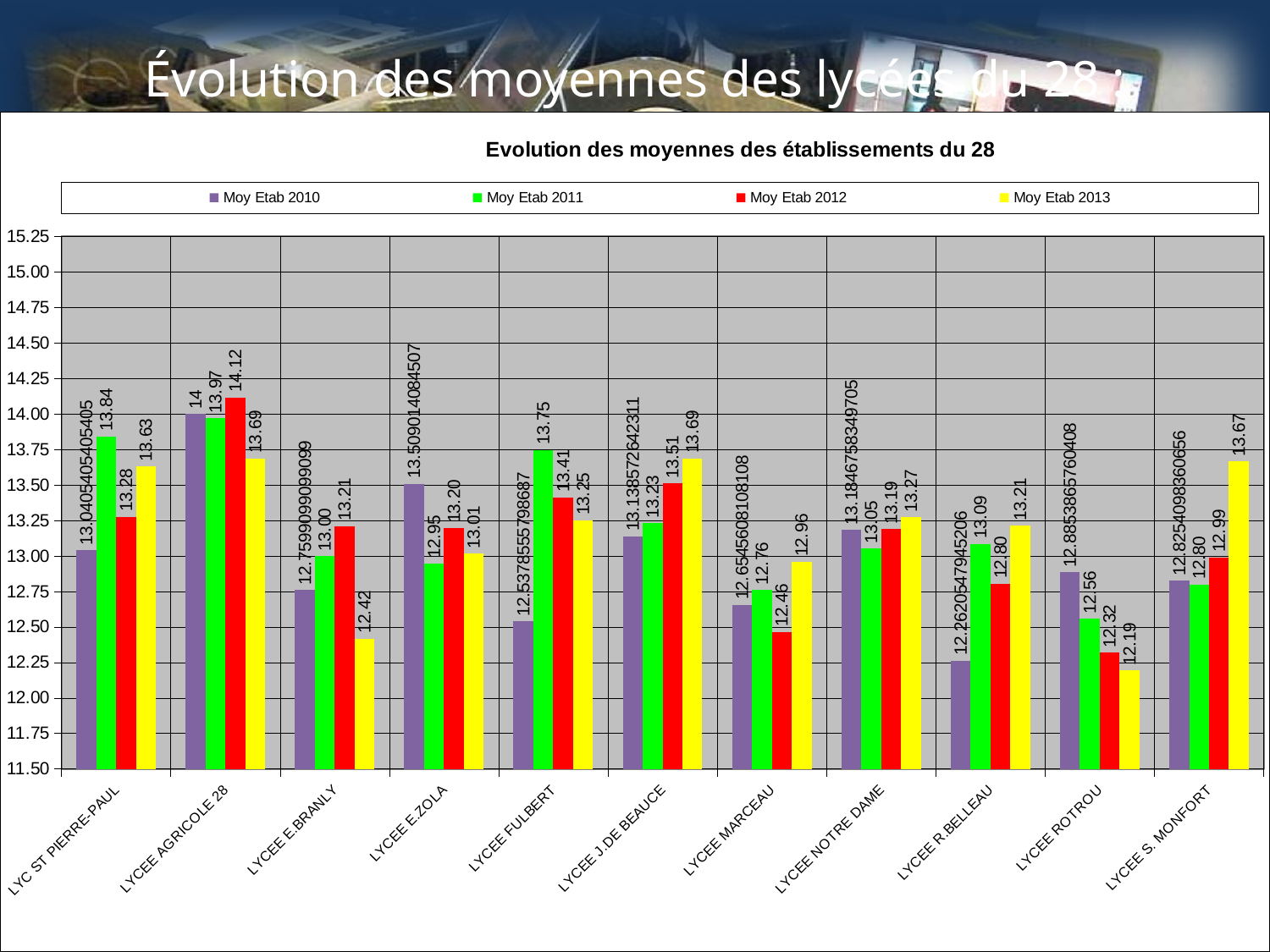
What is the Moy Etab 2011 value for LYCEE MARCEAU? 12.76 How many series does the legend list? 4 Do the values for LYCEE ROTROU rise or fall from Moy Etab 2010 to Moy Etab 2013? fall What kind of chart is shown on the slide? bar chart How many lycées are shown on the x axis? 11 What is the difference between the Moy Etab 2013 values of LYCEE J.DE BEAUCE and LYCEE E.BRANLY? 1.27 Which lycée has the highest Moy Etab 2012 value? LYCEE AGRICOLE 28 Is the Moy Etab 2010 value for LYCEE R.BELLEAU greater or less than 12.50? less What is the Moy Etab 2012 value for LYCEE FULBERT? 13.41 Which lycée has the lowest Moy Etab 2013 value? LYCEE ROTROU What is the Moy Etab 2013 value for LYCEE S. MONFORT? 13.67 Which is larger: the Moy Etab 2011 value for LYC ST PIERRE-PAUL or for LYCEE E.ZOLA? LYC ST PIERRE-PAUL